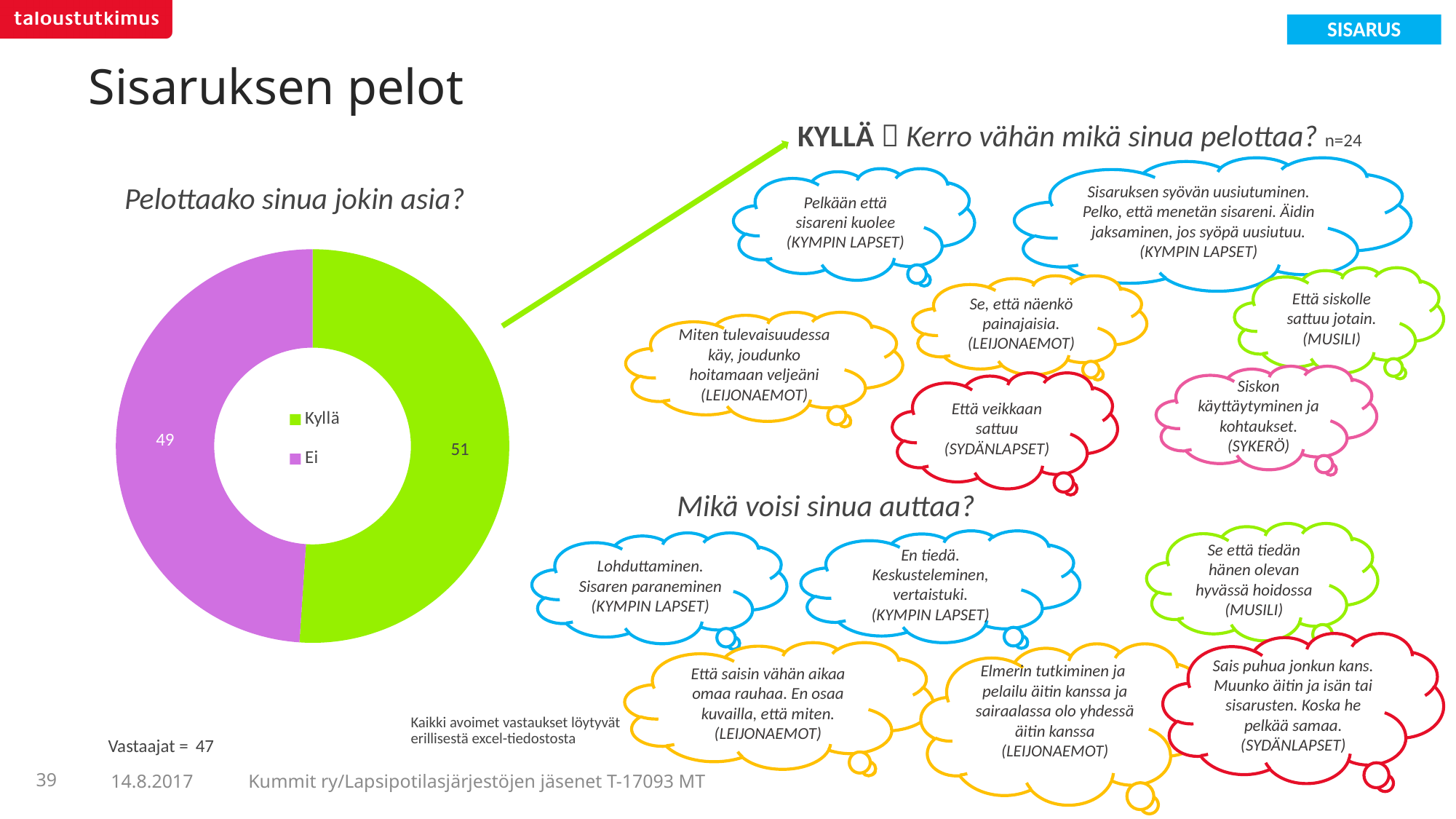
How many categories does the chart 'Pelottaako sinua jokin asia?' show? 2 What share of the chart 'Pelottaako sinua jokin asia?' does the Kyllä slice represent? 51 What value is shown for Kyllä in the chart 'Pelottaako sinua jokin asia?'? 51 Which category has the larger value in the chart 'Pelottaako sinua jokin asia?'? Kyllä What colour is the Ei slice in the chart 'Pelottaako sinua jokin asia?'? purple What is the total of the two values in the chart 'Pelottaako sinua jokin asia?'? 100 Is the value for Kyllä larger or smaller than the value for Ei in the chart 'Pelottaako sinua jokin asia?'? larger What kind of chart is 'Pelottaako sinua jokin asia?'? doughnut chart What is the difference between the Kyllä and Ei values in the chart 'Pelottaako sinua jokin asia?'? 2 What value is shown for Ei in the chart 'Pelottaako sinua jokin asia?'? 49 How many entries does the legend of the chart 'Pelottaako sinua jokin asia?' list? 2 Which category has the smaller value in the chart 'Pelottaako sinua jokin asia?'? Ei